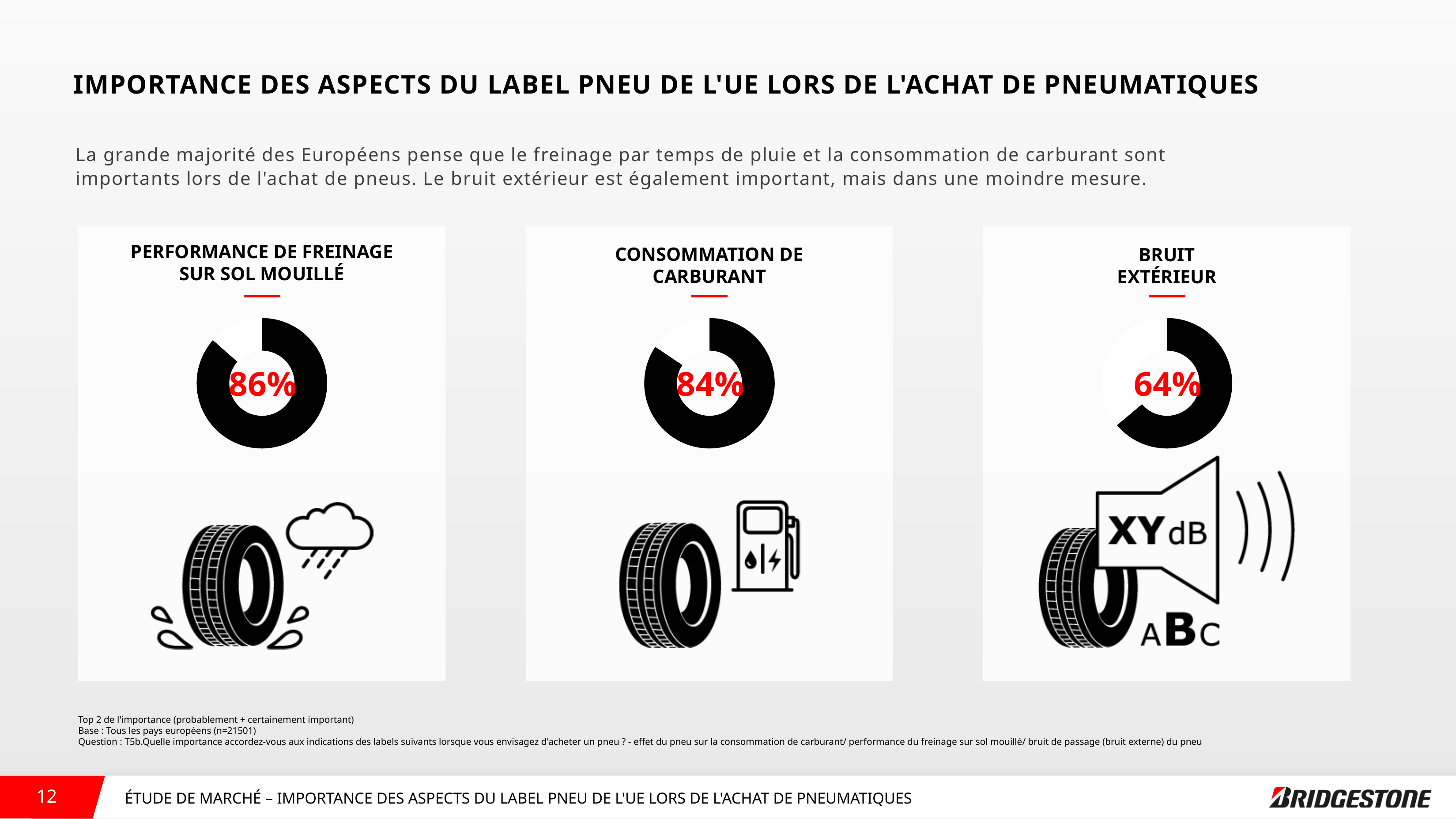
Which is larger, the percentage for 'Consommation de carburant' or for 'Bruit extérieur'? Consommation de carburant What colour is the filled portion of each donut chart? Black Which of the three aspects has the lowest percentage? Bruit extérieur Which of the three aspects has the highest percentage? Performance de freinage sur sol mouillé What kind of chart is used to display each percentage on the slide? Donut chart How many donut charts are shown on the slide? 3 What colour are the percentage labels in the centre of the donut charts? Red What percentage is shown in the donut chart for 'Performance de freinage sur sol mouillé'? 86% What is the difference in percentage points between 'Performance de freinage sur sol mouillé' and 'Bruit extérieur'? 22 What percentage is shown in the donut chart for 'Consommation de carburant'? 84% What is the difference in percentage points between 'Consommation de carburant' and 'Bruit extérieur'? 20 What percentage is shown in the donut chart for 'Bruit extérieur'? 64%